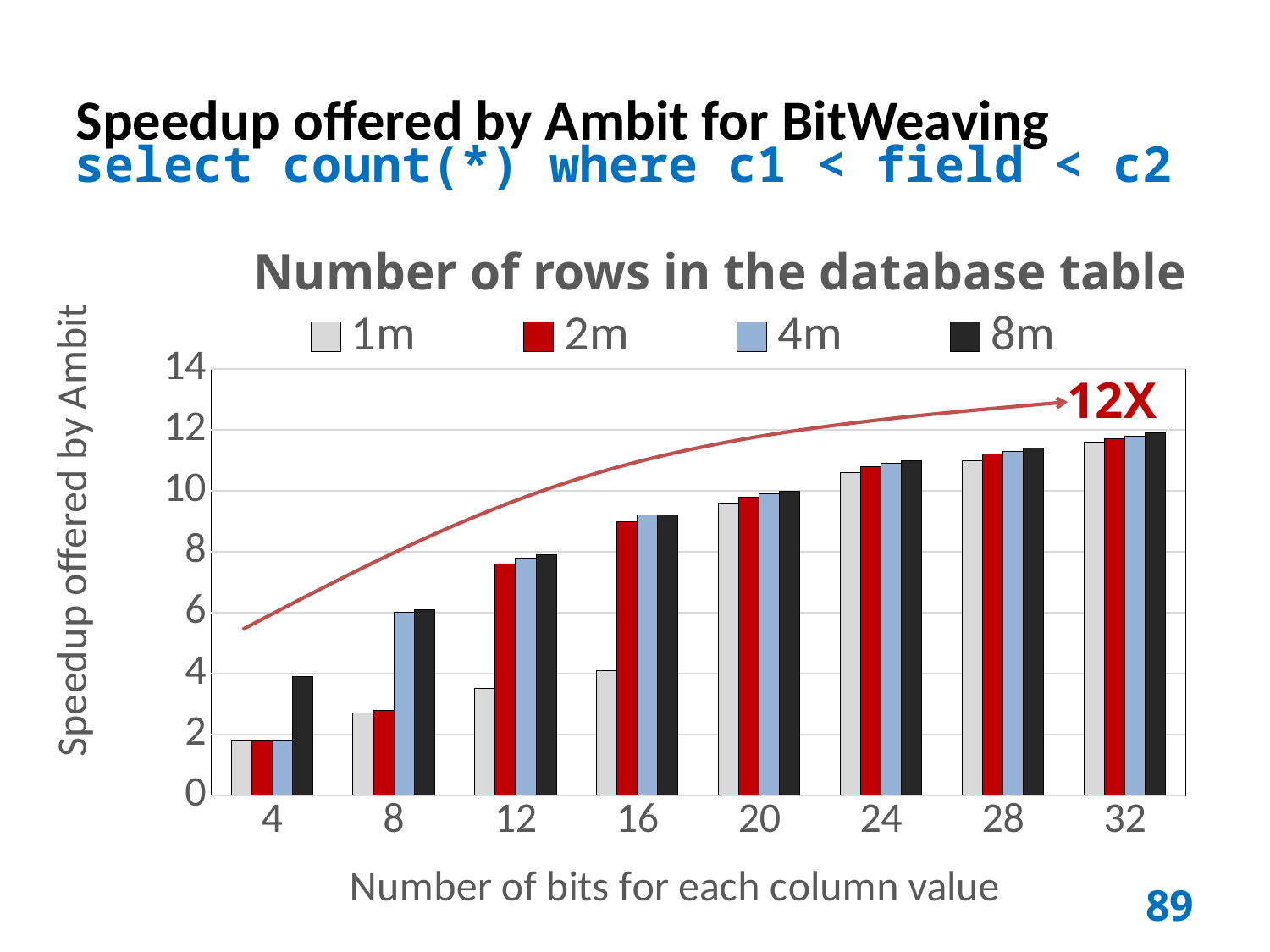
Is the speedup for the 8m series at 32 bits greater or less than 10? greater Is the speedup for the 1m series at 4 bits greater or less than 2? less At 16 bits, which series has the larger speedup, 1m or 2m? 2m How many series does the legend list? 4 What kind of chart is shown on the slide? bar chart For the 8m series, at which number of bits is the speedup highest? 32 What is the title of the chart's legend group above the bars? Number of rows in the database table At 4 bits, which series has the larger speedup, 1m or 8m? 8m Is the speedup for the 2m series at 16 bits greater or less than 8? greater How many bit-width categories are shown on the x axis? 8 Do the speedup values rise or fall as the number of bits for each column value increases? rise